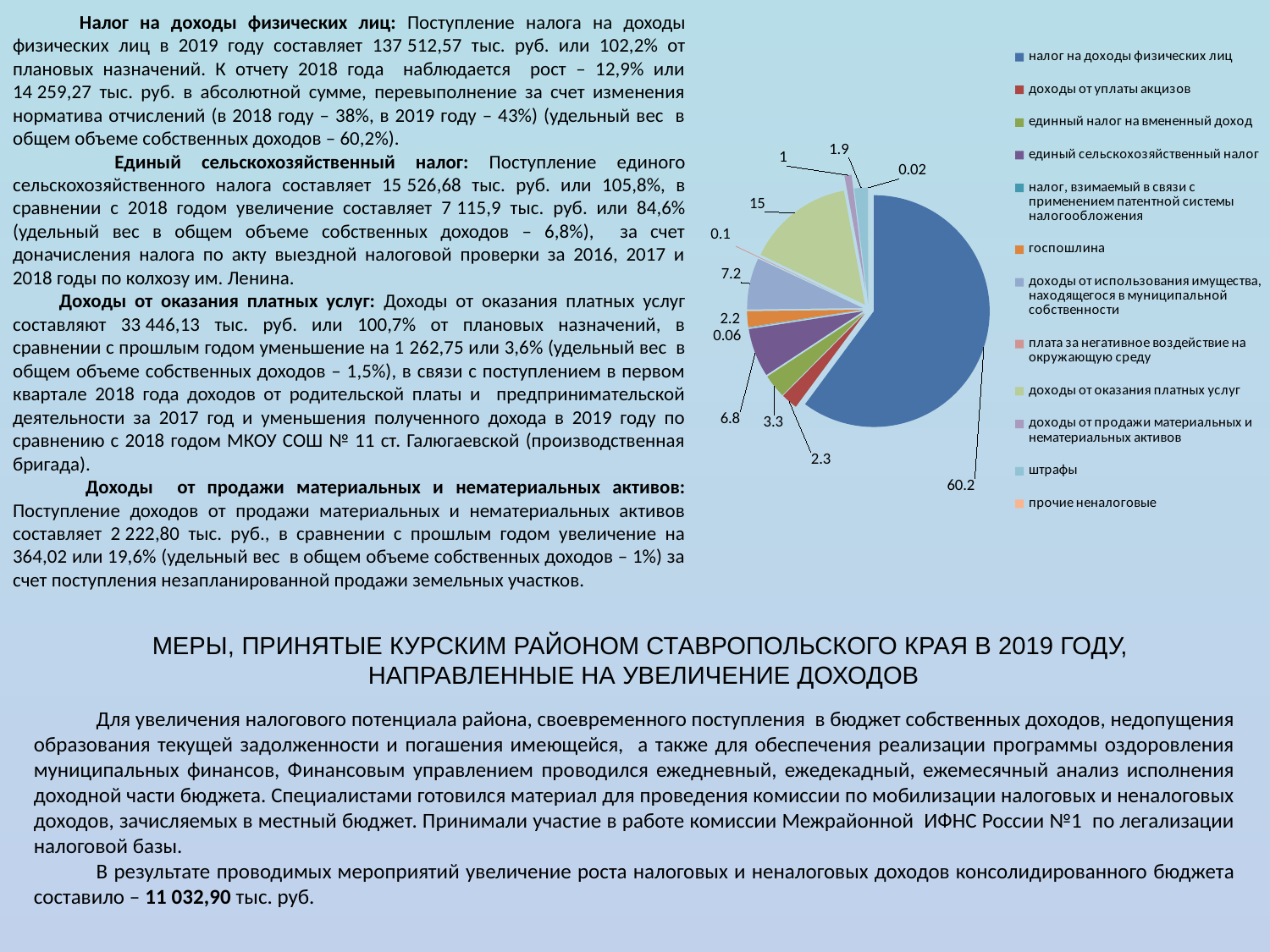
What value is shown for "доходы от уплаты акцизов" in the pie chart? 2.3 What value is shown for "доходы от оказания платных услуг" in the pie chart? 15 What value is shown for "единый сельскохозяйственный налог" in the pie chart? 6.8 What is the difference between the values for "налог на доходы физических лиц" and "доходы от оказания платных услуг" in the pie chart? 45.2 What value is shown for "штрафы" in the pie chart? 1.9 What value is shown for "налог на доходы физических лиц" in the pie chart? 60.2 Which category has the largest slice in the pie chart? налог на доходы физических лиц How many entries does the legend of the pie chart list? 12 What kind of chart is shown on the slide? pie chart Which category has the smallest value in the pie chart? прочие неналоговые Which is larger in the pie chart: "единый сельскохозяйственный налог" or "единый налог на вмененный доход"? единый сельскохозяйственный налог What colour is the slice for "налог на доходы физических лиц" in the pie chart? blue